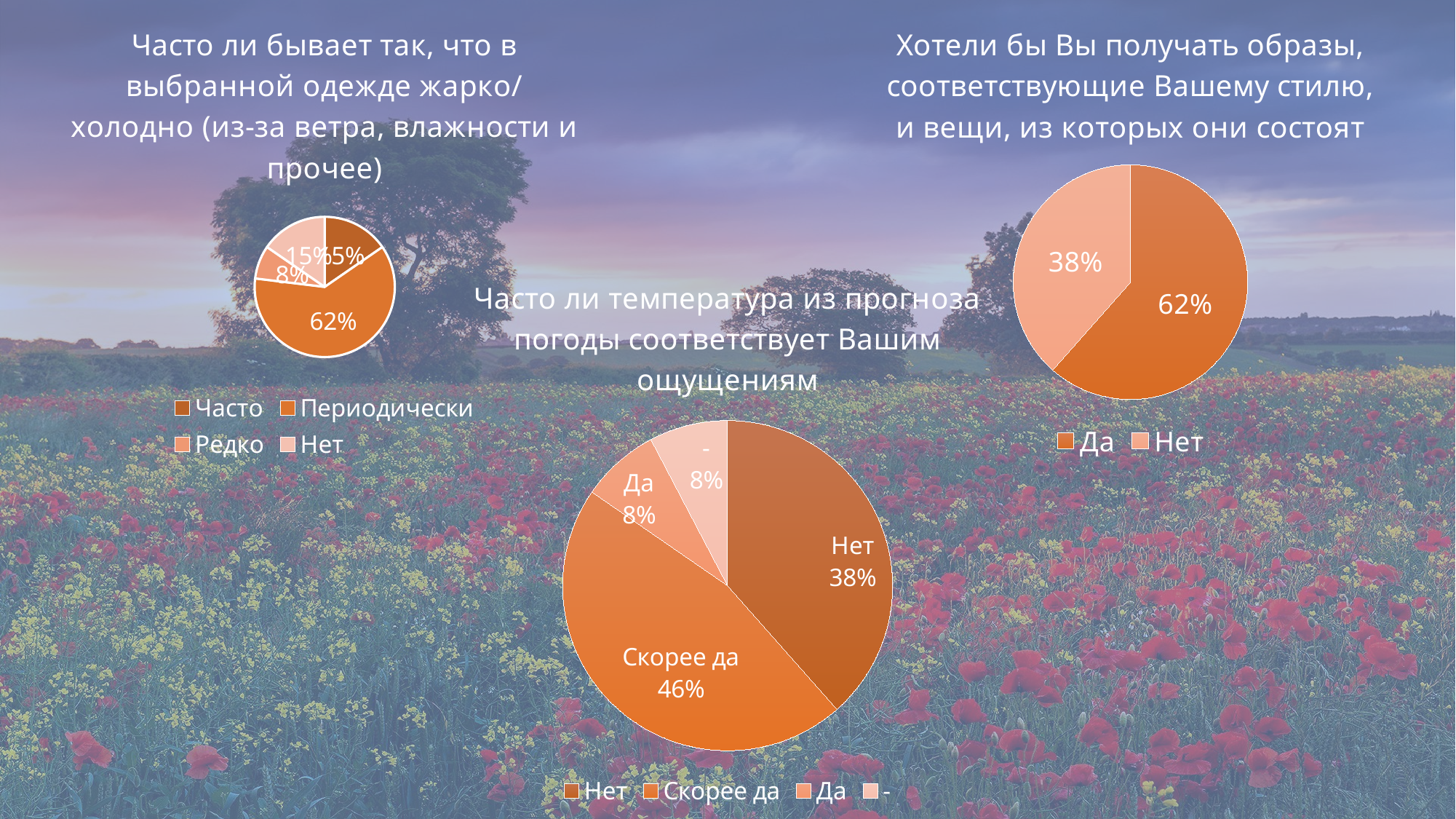
In the chart titled "Хотели бы Вы получать образы, соответствующие Вашему стилю, и вещи, из которых они состоят", what is the difference between the "Да" and "Нет" shares? 24% In the chart titled "Часто ли температура из прогноза погоды соответствует Вашим ощущениям", which answer has the largest share? Скорее да In the chart titled "Часто ли температура из прогноза погоды соответствует Вашим ощущениям", what share of respondents answered "Нет"? 38% In the chart titled "Часто ли бывает так, что в выбранной одежде жарко/холодно", which answer has the largest share? Периодически In the chart titled "Часто ли температура из прогноза погоды соответствует Вашим ощущениям", how many categories does the legend list? 4 In the chart titled "Хотели бы Вы получать образы, соответствующие Вашему стилю, и вещи, из которых они состоят", what share of respondents answered "Да"? 62% What type of chart is used for the chart titled "Хотели бы Вы получать образы, соответствующие Вашему стилю, и вещи, из которых они состоят"? Pie chart In the chart titled "Хотели бы Вы получать образы, соответствующие Вашему стилю, и вещи, из которых они состоят", what share of respondents answered "Нет"? 38% In the chart titled "Часто ли температура из прогноза погоды соответствует Вашим ощущениям", what share of respondents answered "Скорее да"? 46% In the chart titled "Часто ли бывает так, что в выбранной одежде жарко/холодно", what share of respondents answered "Периодически"? 62% In the chart titled "Часто ли бывает так, что в выбранной одежде жарко/холодно", what share of respondents answered "Редко"? 8% In the chart titled "Часто ли температура из прогноза погоды соответствует Вашим ощущениям", which is larger: the share for "Нет" or the share for "Да"? Нет